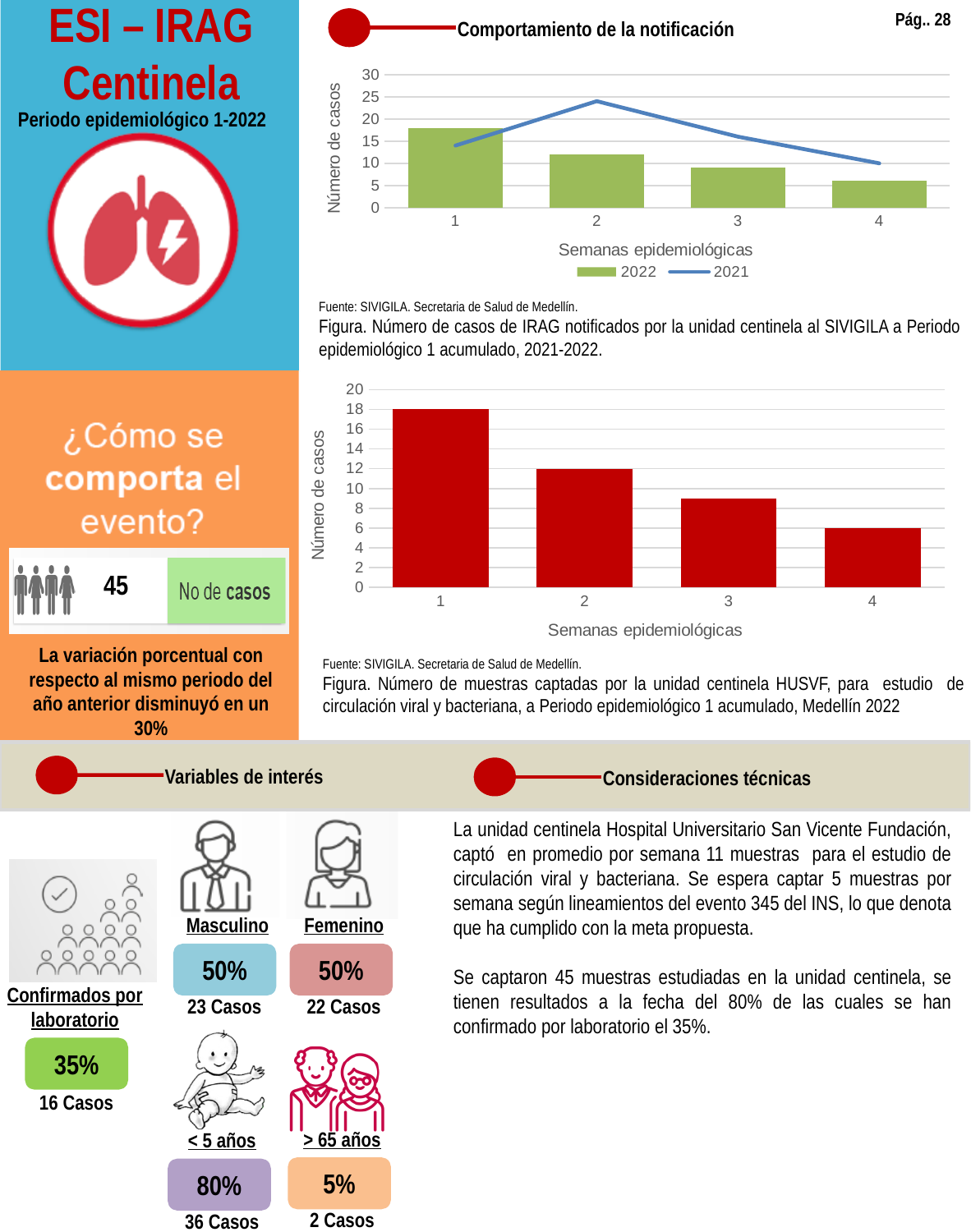
In the top chart (Comportamiento de la notificación), is the 2021 value for week 2 greater or less than 20? greater In the bottom chart (Número de muestras captadas), what is the value for week 4? 6 In the bottom chart (Número de muestras captadas), what is the value for week 1? 18 In the top chart (Comportamiento de la notificación), how many series does the legend list? 2 In the top chart (Comportamiento de la notificación), do the 2022 bars rise or fall from week 1 to week 4? fall In the bottom chart (Número de muestras captadas), how many epidemiological weeks are shown on the x axis? 4 In the top chart (Comportamiento de la notificación), which epidemiological week has the highest 2022 bar? 1 In the top chart (Comportamiento de la notificación), which epidemiological week has the lowest 2022 bar? 4 In the top chart (Comportamiento de la notificación), what kind of chart is it? A combined bar and line chart In the bottom chart (Número de muestras captadas), what is the value for week 2? 12 In the top chart (Comportamiento de la notificación), in week 2, which series is larger, 2022 or 2021? 2021 In the bottom chart (Número de muestras captadas), what is the difference between the values for week 1 and week 4? 12